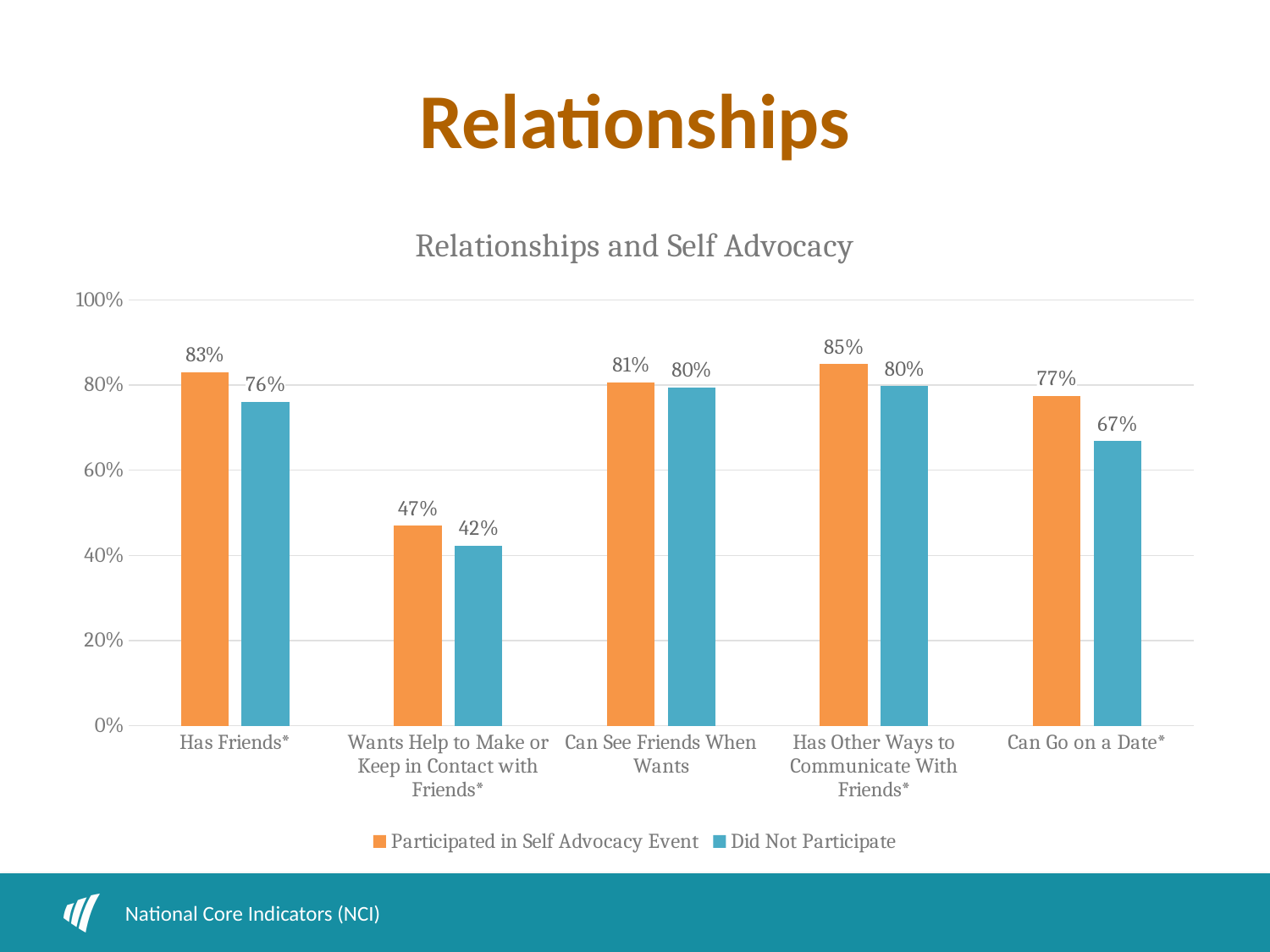
What is the value for 'Wants Help to Make or Keep in Contact with Friends*' in the 'Did Not Participate' series? 42% What is the value for 'Has Friends*' in the 'Participated in Self Advocacy Event' series? 83% Which category has the highest value in the 'Participated in Self Advocacy Event' series? Has Other Ways to Communicate With Friends* Which category has the lowest value in the 'Did Not Participate' series? Wants Help to Make or Keep in Contact with Friends* What is the value for 'Can Go on a Date*' in the 'Did Not Participate' series? 67% For 'Has Friends*', which series has the larger value: 'Participated in Self Advocacy Event' or 'Did Not Participate'? Participated in Self Advocacy Event How many categories are shown on the x axis? 5 How many series does the legend list? 2 Is the 'Did Not Participate' value for 'Wants Help to Make or Keep in Contact with Friends*' greater or less than 60%? less What kind of chart is shown on the slide? bar chart What is the title of the chart? Relationships and Self Advocacy What is the difference between the 'Participated in Self Advocacy Event' and 'Did Not Participate' values for 'Can Go on a Date*'? 10%